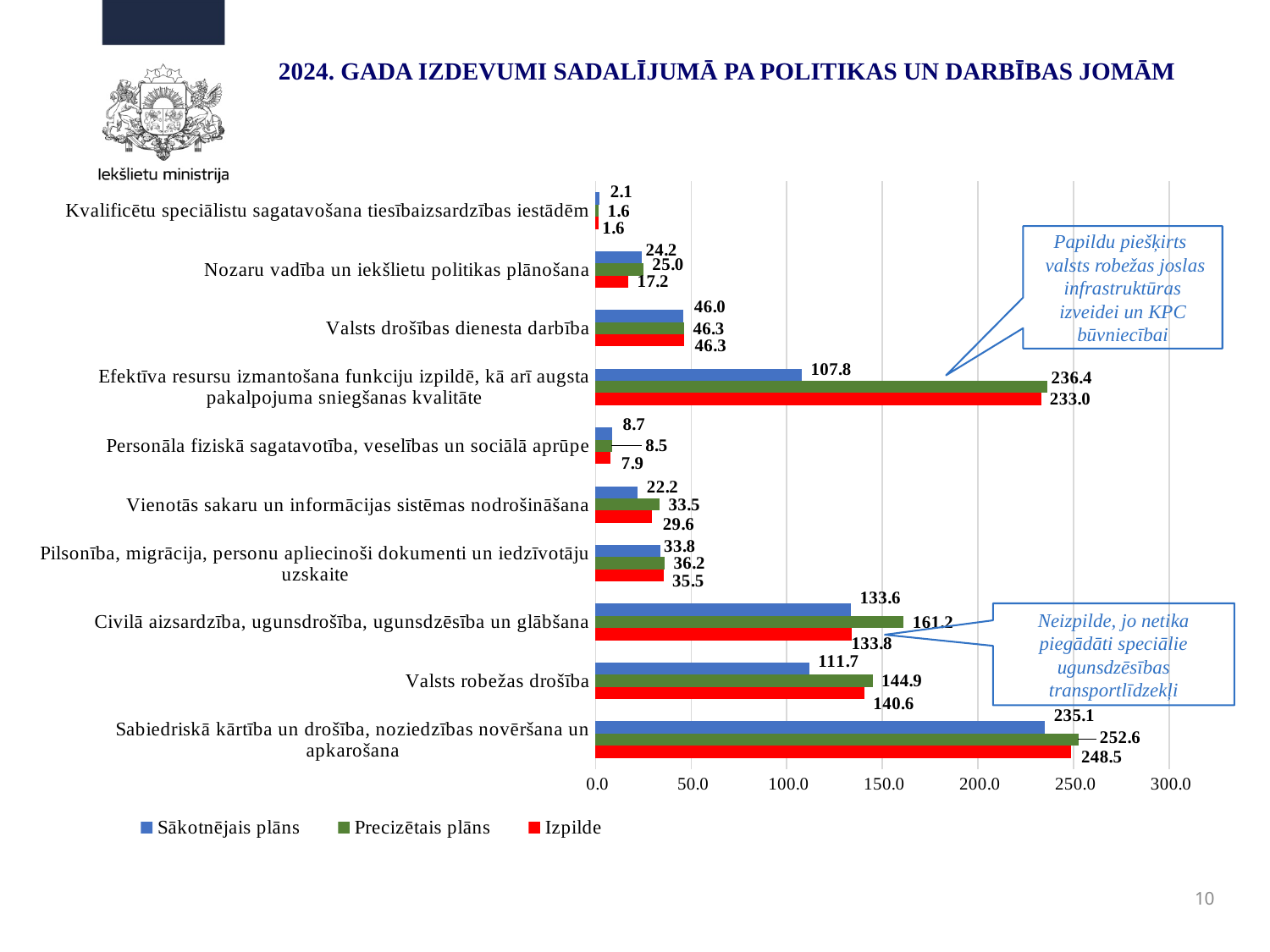
Which category has the lowest Sākotnējais plāns value? Kvalificētu speciālistu sagatavošana tiesībaizsardzības iestādēm What is the Precizētais plāns value for Civilā aizsardzība, ugunsdrošība, ugunsdzēsība un glābšana? 161.2 What type of chart is shown on the slide? bar chart What is the Sākotnējais plāns value for Efektīva resursu izmantošana funkciju izpildē, kā arī augsta pakalpojuma sniegšanas kvalitāte? 107.8 What is the Izpilde value for Valsts robežas drošība? 140.6 Which category has the highest Izpilde value? Sabiedriskā kārtība un drošība, noziedzības novēršana un apkarošana How many series does the legend list? 3 What is the difference between the Precizētais plāns and Sākotnējais plāns values for Valsts robežas drošība? 33.2 How many categories are plotted on the chart? 10 Which series is shown in red in the legend? Izpilde Is the Izpilde value for Efektīva resursu izmantošana funkciju izpildē, kā arī augsta pakalpojuma sniegšanas kvalitāte greater or less than 200.0? greater Which is larger for Nozaru vadība un iekšlietu politikas plānošana: the Precizētais plāns value or the Izpilde value? Precizētais plāns